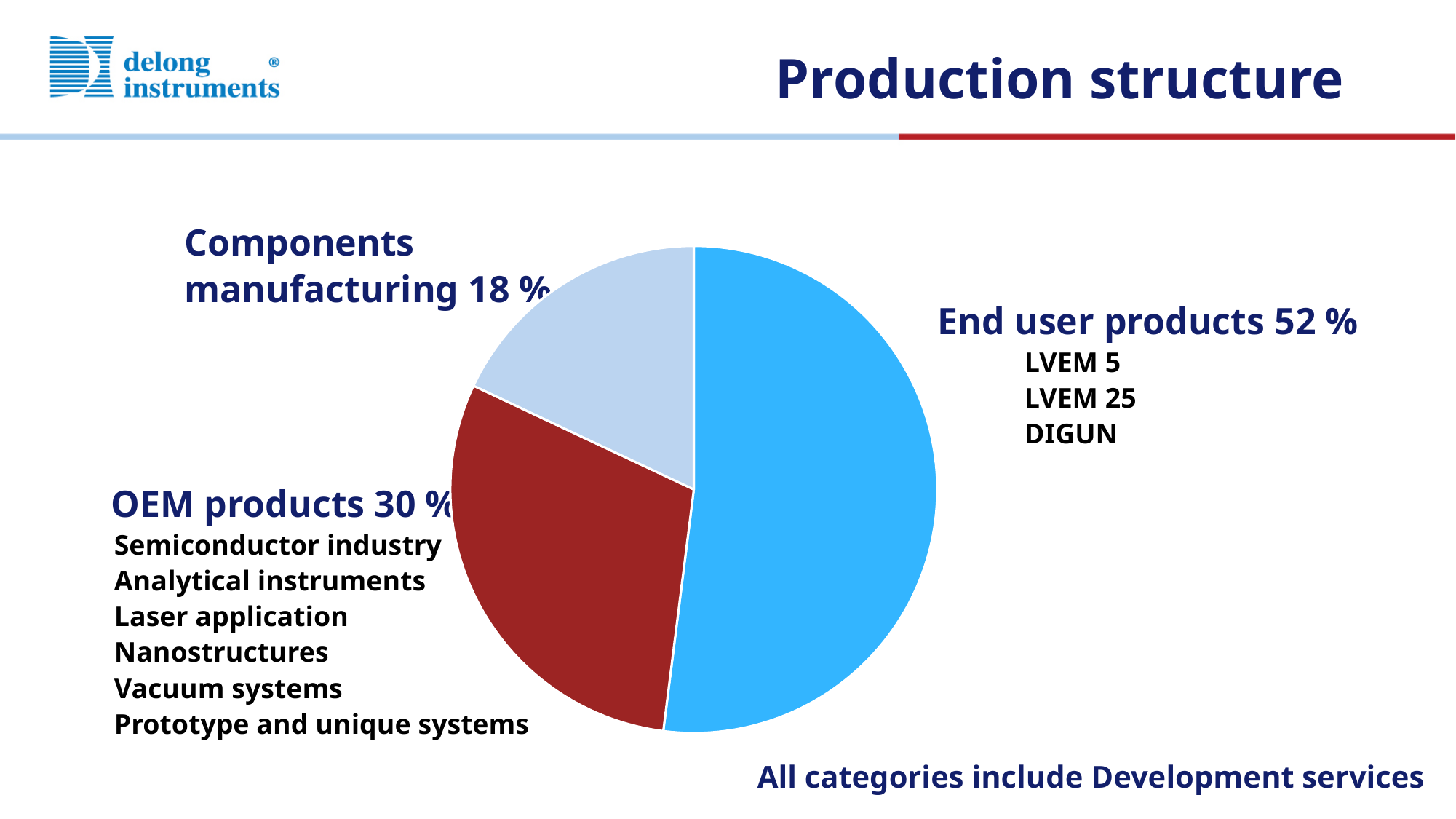
How many slices does the pie chart have? 3 What is the difference in percentage points between OEM products and Components manufacturing? 12 What is the difference in percentage points between End user products and OEM products? 22 What is the title of the slide containing the pie chart? Production structure What share of production is End user products? 52 % Which is larger, the share for OEM products or the share for Components manufacturing? OEM products Which category has the largest share of the pie? End user products What share of production is OEM products? 30 % What colour is the End user products slice? blue Which category has the smallest share of the pie? Components manufacturing What share of production is Components manufacturing? 18 % What kind of chart is shown on the slide? pie chart